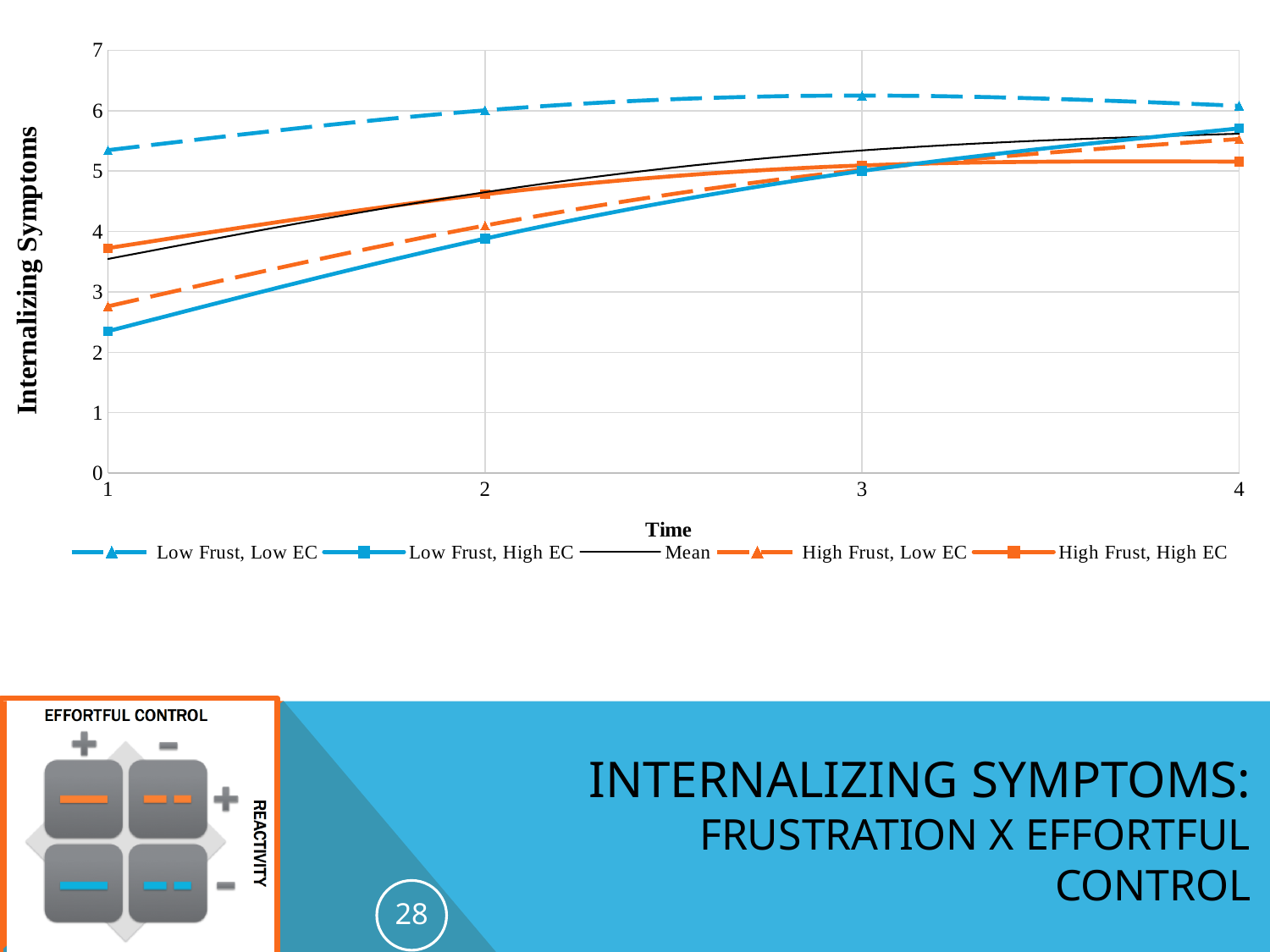
Is the value for Low Frust, High EC at time 1 greater or less than 3? less Is the value for Low Frust, Low EC at time 1 greater or less than 5? greater Which series has the highest value at time 1? Low Frust, Low EC What is the label on the y axis of the chart? Internalizing Symptoms Which series has the lowest value at time 1? Low Frust, High EC How many series does the legend list? 5 At time 4, which series is higher: Low Frust, Low EC or High Frust, High EC? Low Frust, Low EC What kind of chart is shown on the slide? Line chart At time 1, which series is higher: Low Frust, Low EC or Low Frust, High EC? Low Frust, Low EC Does the Low Frust, High EC series rise or fall from time 1 to time 4? Rises Is the value for High Frust, High EC at time 4 greater or less than 6? less How many time points are plotted along the x axis? 4